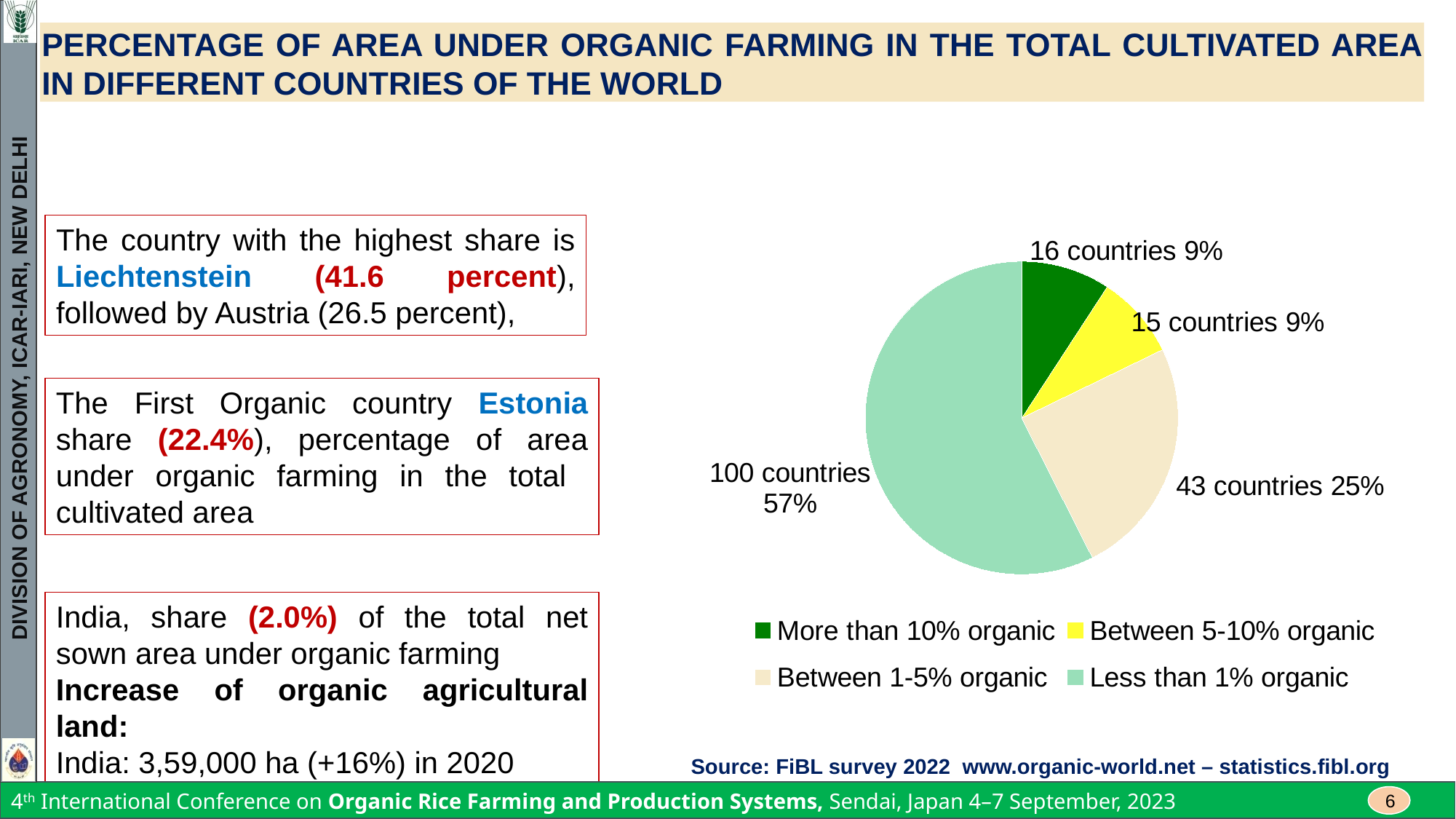
What colour is the 'More than 10% organic' slice in the pie chart? dark green How many countries fall in the 'Less than 1% organic' category? 100 countries What is the difference in the number of countries between the 'Less than 1% organic' and 'Between 1-5% organic' categories? 57 countries Which category has more countries: 'Between 1-5% organic' or 'More than 10% organic'? Between 1-5% organic What percentage share of the pie does the 'Less than 1% organic' slice represent? 57% Which category has the smallest number of countries? Between 5-10% organic How many categories does the pie chart have? 4 What percentage share of the pie does the 'Between 5-10% organic' slice represent? 9% How many countries fall in the 'More than 10% organic' category? 16 countries Which category has the largest number of countries? Less than 1% organic What kind of chart is shown on the slide? pie chart How many countries fall in the 'Between 1-5% organic' category? 43 countries